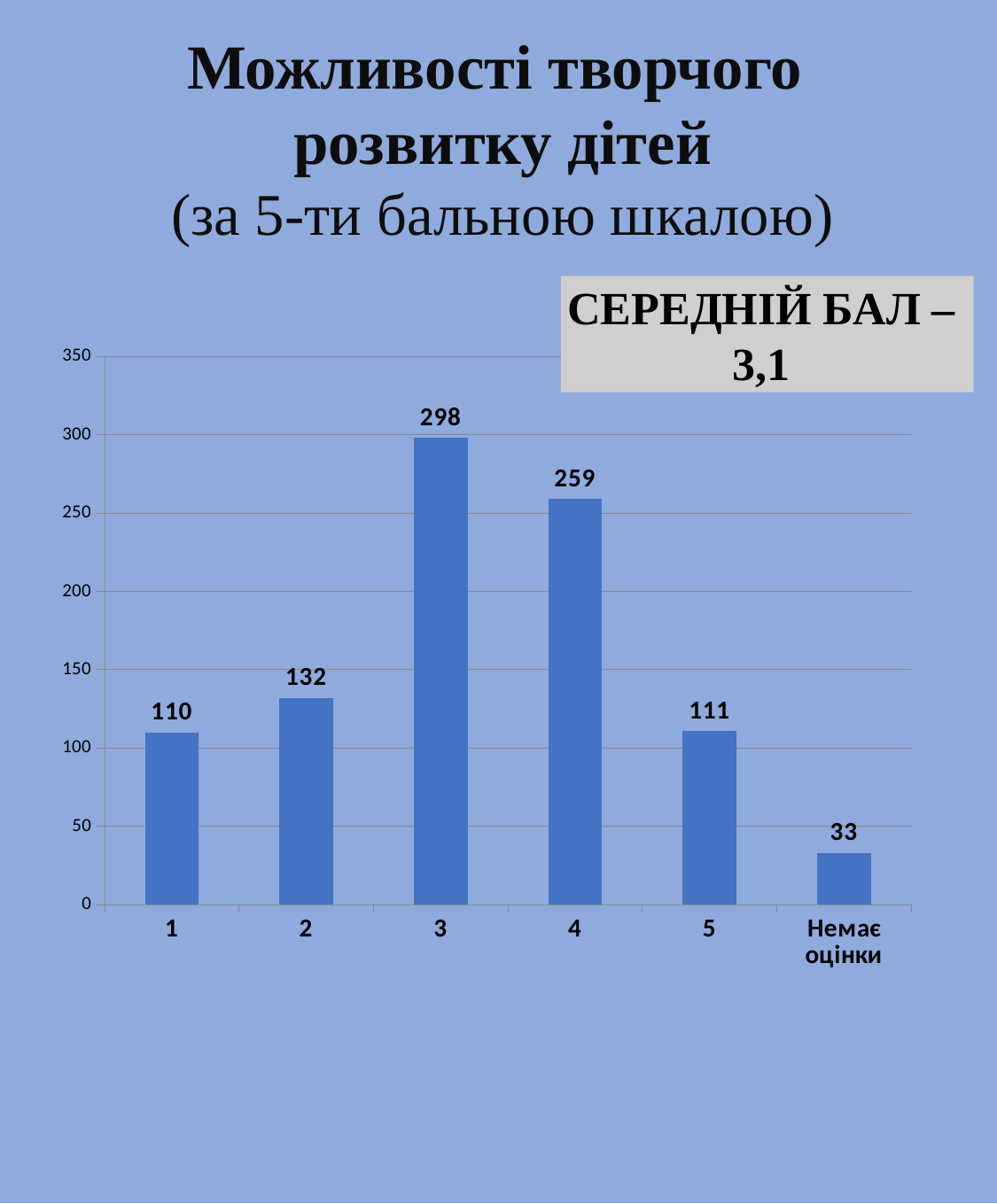
How many categories are shown on the x axis? 6 What is the value for category 1? 110 Which category has the lowest value? Немає оцінки What kind of chart is shown on the slide? bar chart Is the value for category 4 greater or less than 250? greater What is the value for the category 'Немає оцінки'? 33 What is the difference between the values for category 3 and category 4? 39 Which is larger, the value for category 2 or the value for category 5? 2 What average score (середній бал) is stated in the box on the slide? 3,1 Which category has the highest value? 3 What is the difference between the values for category 2 and category 1? 22 What is the value for category 3? 298